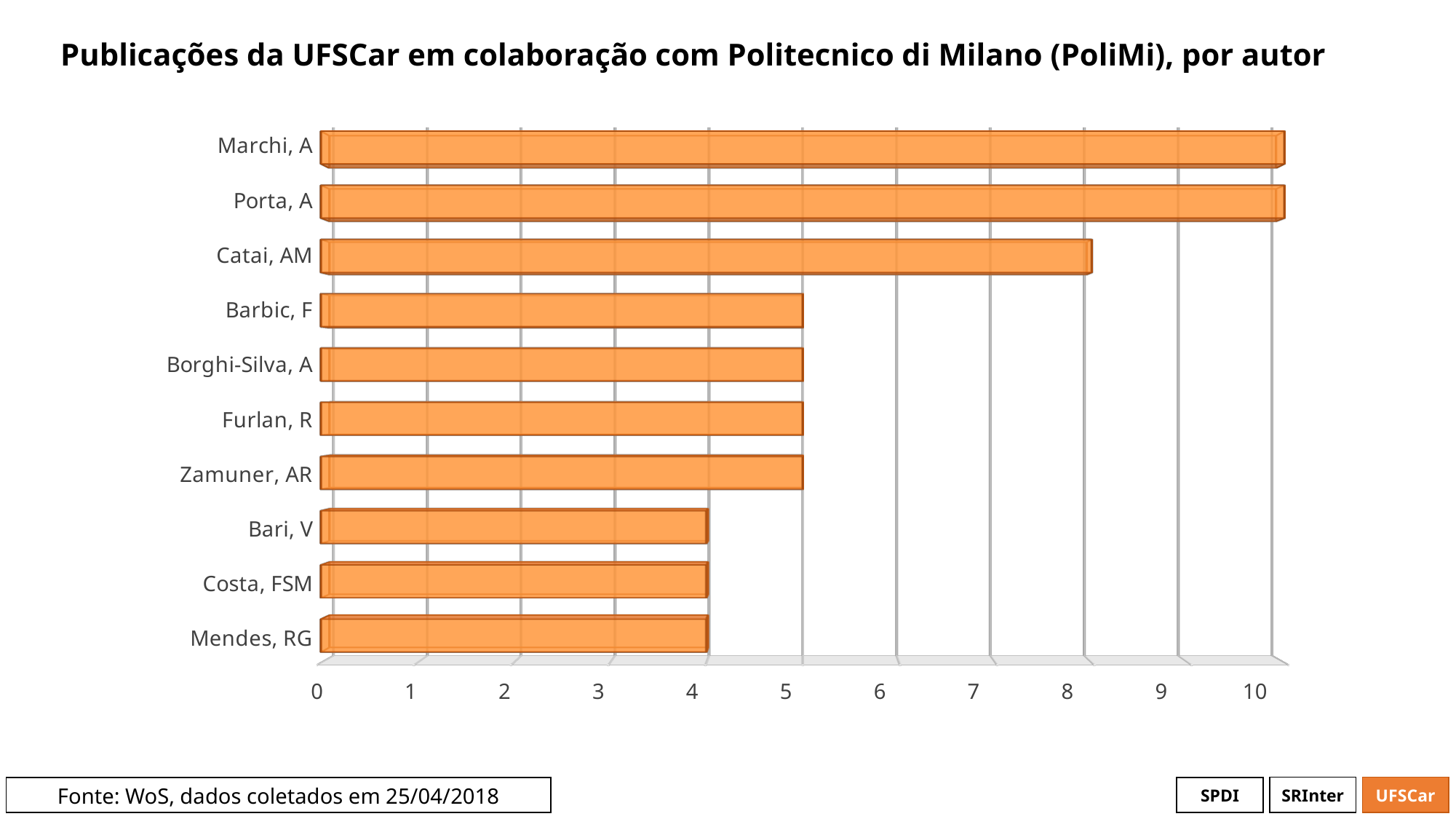
What is the value for Furlan, R? 5 What is the value for Mendes, RG? 4 What is the value for Catai, AM? 8 Which is larger, the value for Catai, AM or the value for Barbic, F? Catai, AM How many authors are listed on the chart? 10 Is the value for Catai, AM greater or less than 7? greater What type of chart is shown on the slide? bar chart Which is larger, the value for Zamuner, AR or the value for Costa, FSM? Zamuner, AR What is the value for Marchi, A? 10 What is the difference between the values for Marchi, A and Catai, AM? 2 What is the title of the chart? Publicações da UFSCar em colaboração com Politecnico di Milano (PoliMi), por autor Is the value for Bari, V greater or less than 5? less